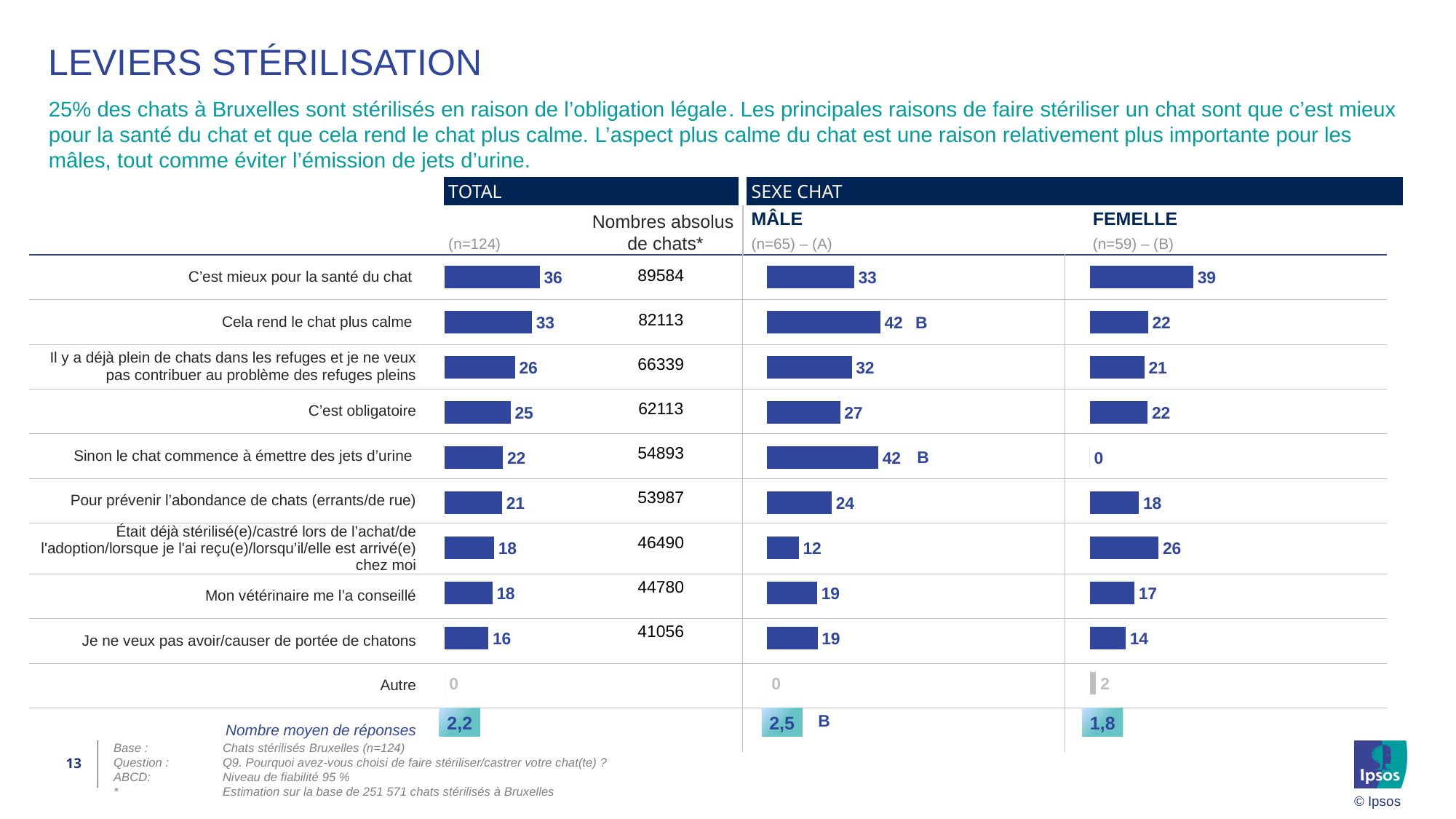
In the FEMELLE chart, which category has the highest value? C'est mieux pour la santé du chat In the MÂLE chart, what is the value for "Cela rend le chat plus calme"? 42 What kind of chart is used to show the TOTAL values? Bar chart What is the "Nombre moyen de réponses" shown for the MÂLE group? 2,5 In the MÂLE chart, what is the difference between "Sinon le chat commence à émettre des jets d'urine" and "Pour prévenir l'abondance de chats (errants/de rue)"? 18 In the TOTAL chart, what is the value for "C'est mieux pour la santé du chat"? 36 In the MÂLE chart, which category has the lowest non-zero value? Était déjà stérilisé(e)/castré lors de l'achat/de l'adoption/lorsque je l'ai reçu(e)/lorsqu'il/elle est arrivé(e) chez moi In the TOTAL chart, what is the difference between "C'est mieux pour la santé du chat" and "Cela rend le chat plus calme"? 3 How many categories are listed in the TOTAL chart, including "Autre"? 10 For "Cela rend le chat plus calme", which is larger: the MÂLE value or the FEMELLE value? MÂLE What is the "Nombres absolus de chats" value for "C'est obligatoire"? 62113 In the FEMELLE chart, what is the value for "Sinon le chat commence à émettre des jets d'urine"? 0